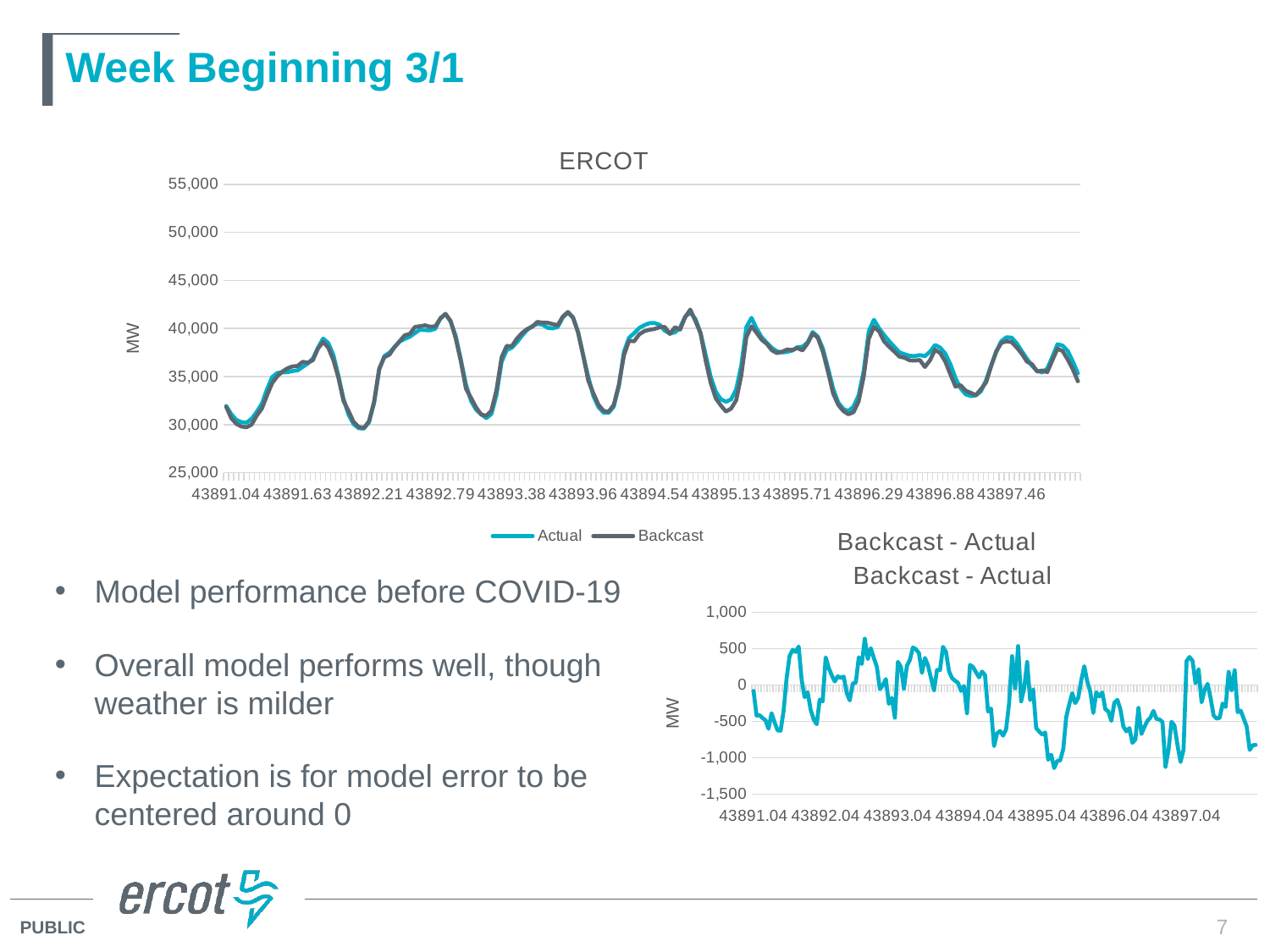
What is the y-axis label of the ERCOT chart? MW In the ERCOT chart, is the highest value reached by the Backcast series greater or less than 45,000? less In the ERCOT chart, is the lowest value of the Actual series greater or less than 25,000? greater In the ERCOT chart, is the highest peak of the Backcast series greater or less than 40,000? greater How many series does the legend of the ERCOT chart list? 2 What are the two series named in the legend of the ERCOT chart? Actual and Backcast In the Backcast - Actual chart, do the values generally rise or fall from the start of the week to the end? fall What kind of chart is the ERCOT chart at the top of the slide? line chart What kind of chart is the Backcast - Actual chart at the bottom right of the slide? line chart